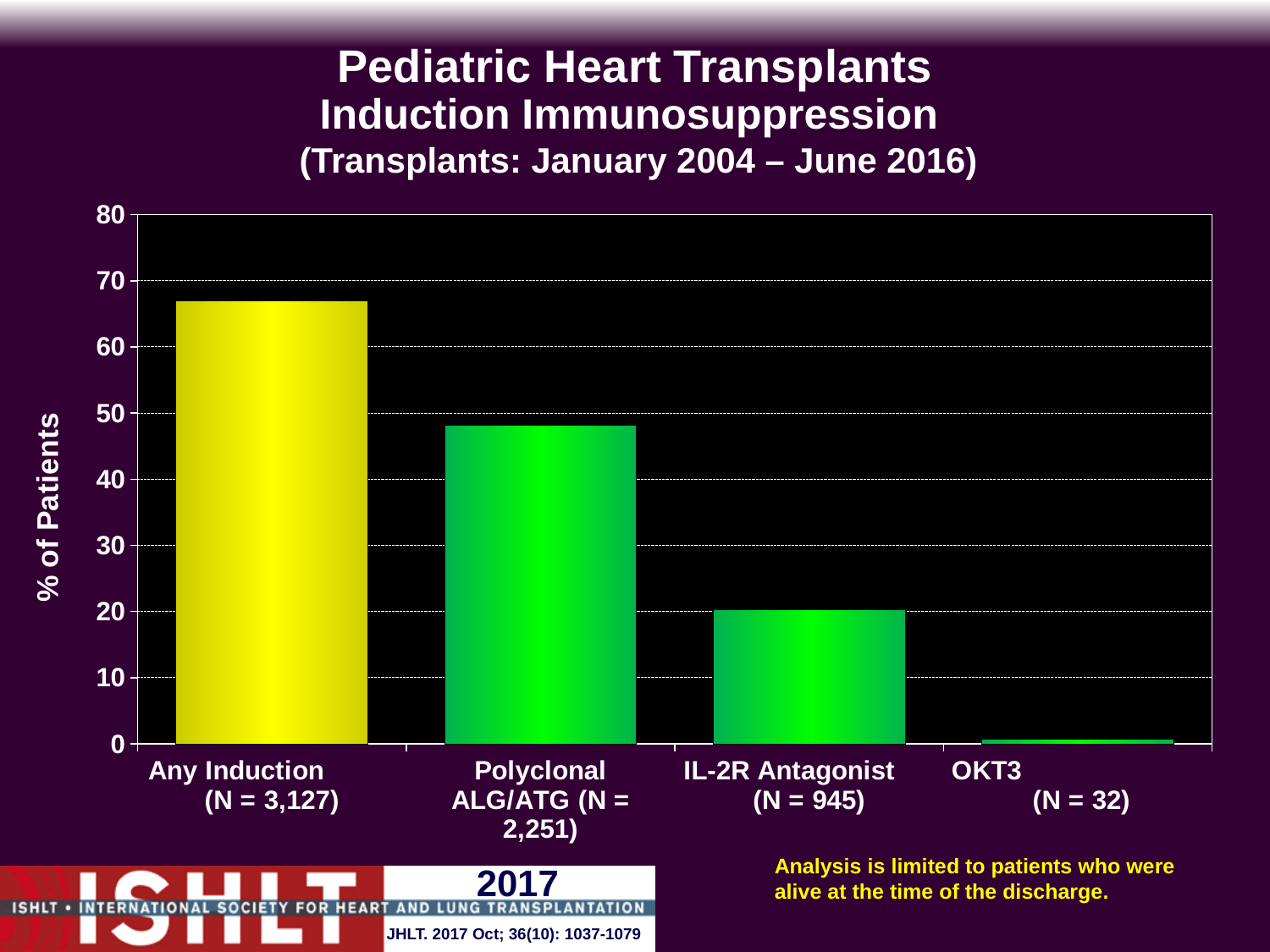
Is the value for OKT3 greater or less than 10? less Which category has the lowest % of Patients? OKT3 Is the value for Any Induction greater or less than 60? greater Is the value for Polyclonal ALG/ATG greater or less than 40? greater Which is larger, the value for Polyclonal ALG/ATG or the value for IL-2R Antagonist? Polyclonal ALG/ATG How many categories are plotted on the chart? 4 Which category has the highest % of Patients? Any Induction What kind of chart is shown on the slide? bar chart What is the label of the y axis? % of Patients